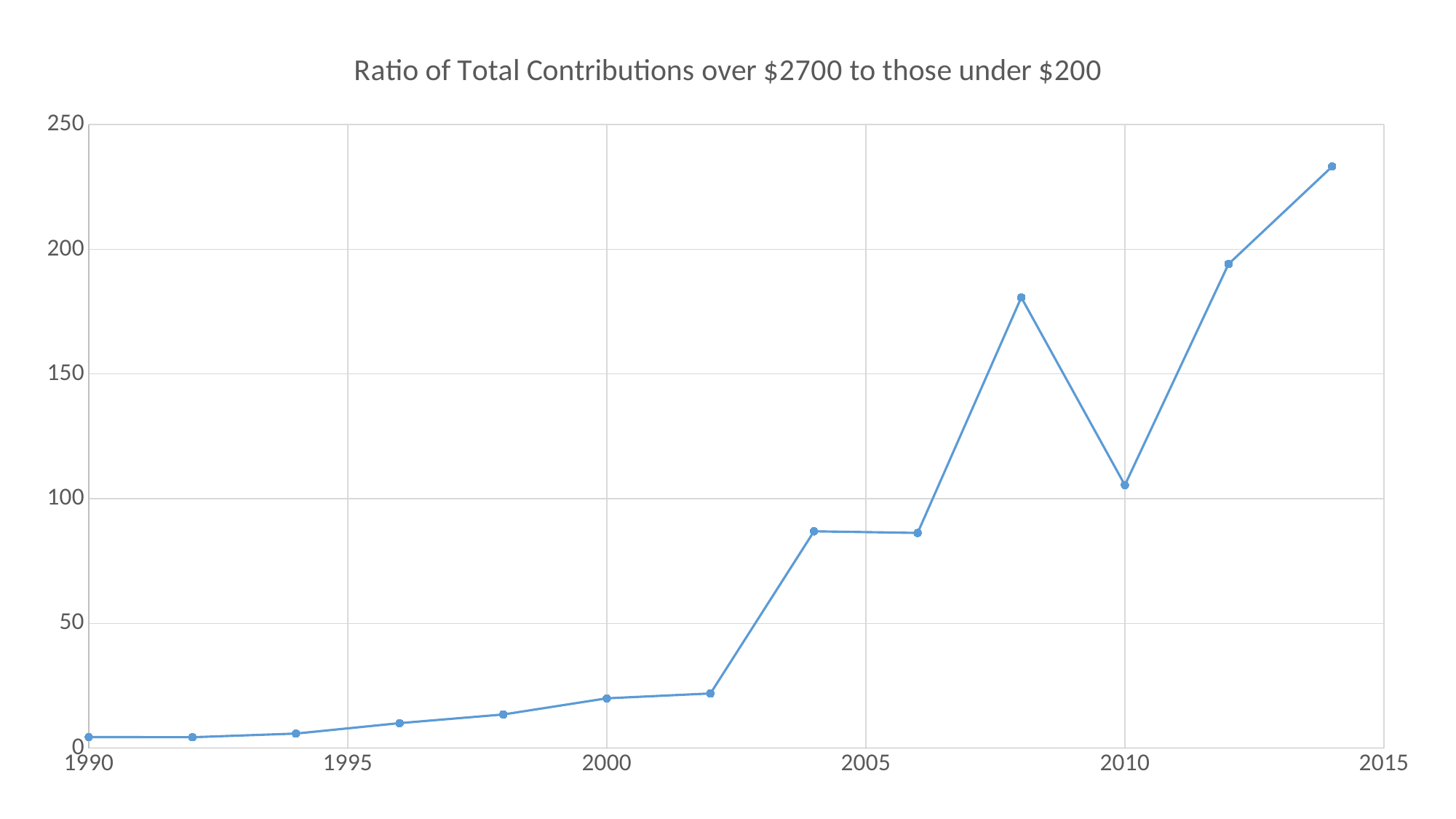
Does the ratio rise or fall between 2008 and 2010? fall Is the value for 2002 greater or less than 50? less Is the value for 2010 greater or less than 100? greater Overall, does the ratio rise or fall from 1990 to 2014? rise How many data points are plotted on the line? 13 What is the title of the chart? Ratio of Total Contributions over $2700 to those under $200 What kind of chart is shown on the slide? line chart Is the value for 2004 greater or less than 100? less In which year is the ratio highest? 2014 Which year has the larger value, 2008 or 2010? 2008